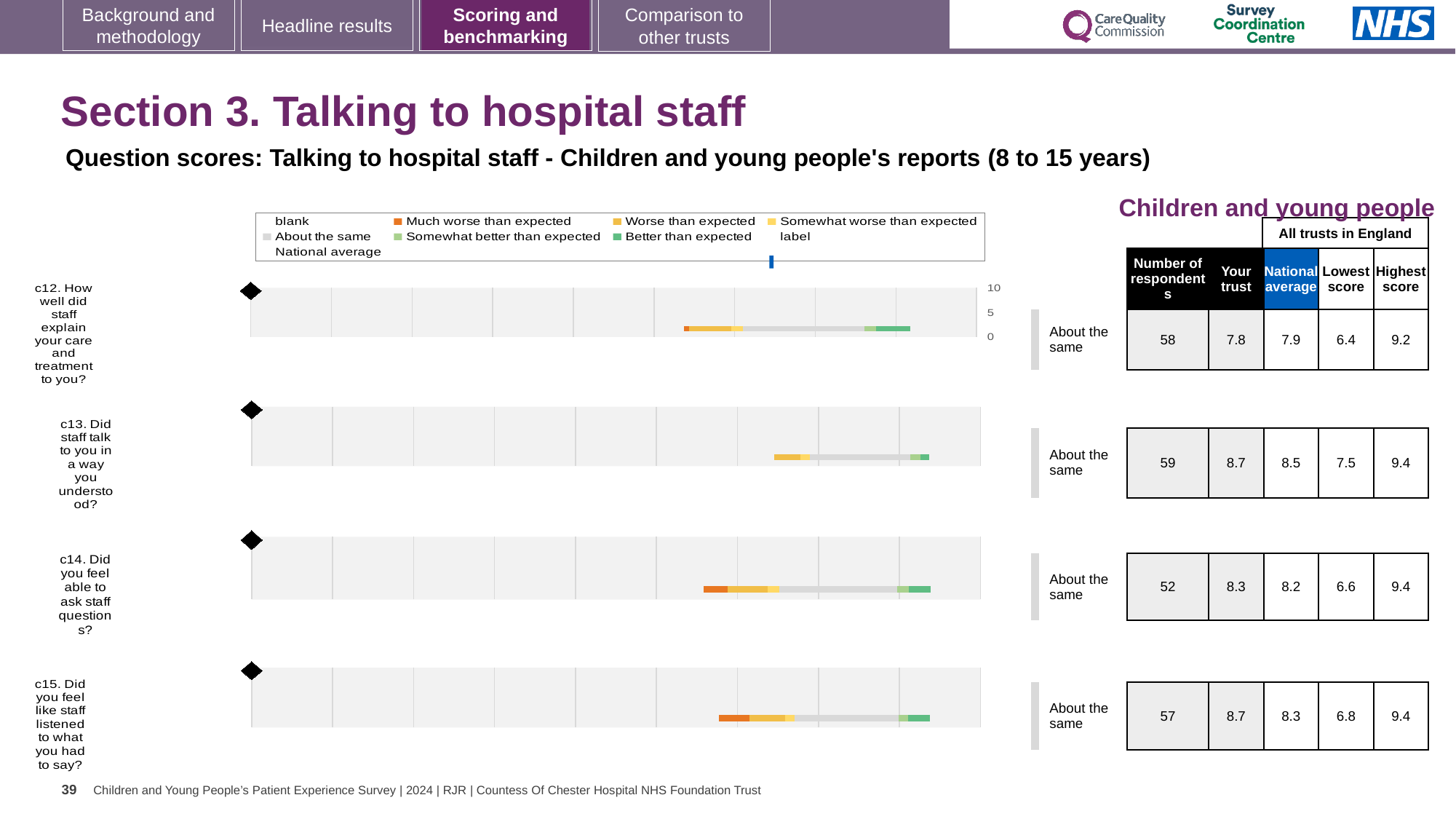
What benchmark category is shown for c12? About the same How many questions are charted on this slide? 4 What is the difference between the 'Your trust' score and the national average for c15? 0.4 Which question has the lowest 'Your trust' score on this slide? c12 For c14, which is larger: the 'Your trust' score or the national average? Your trust What is the national average score for c13 (Did staff talk to you in a way you understood?)? 8.5 What is the 'Your trust' score for c12 (How well did staff explain your care and treatment to you?)? 7.8 What is the lowest score across all trusts in England for c12? 6.4 Which question has the highest number of respondents? c13 What is the highest score across all trusts in England for c15 (Did you feel like staff listened to what you had to say?)? 9.4 How many respondents answered c14 (Did you feel able to ask staff questions?)? 52 What kind of chart is used for each question on this slide? Bar chart